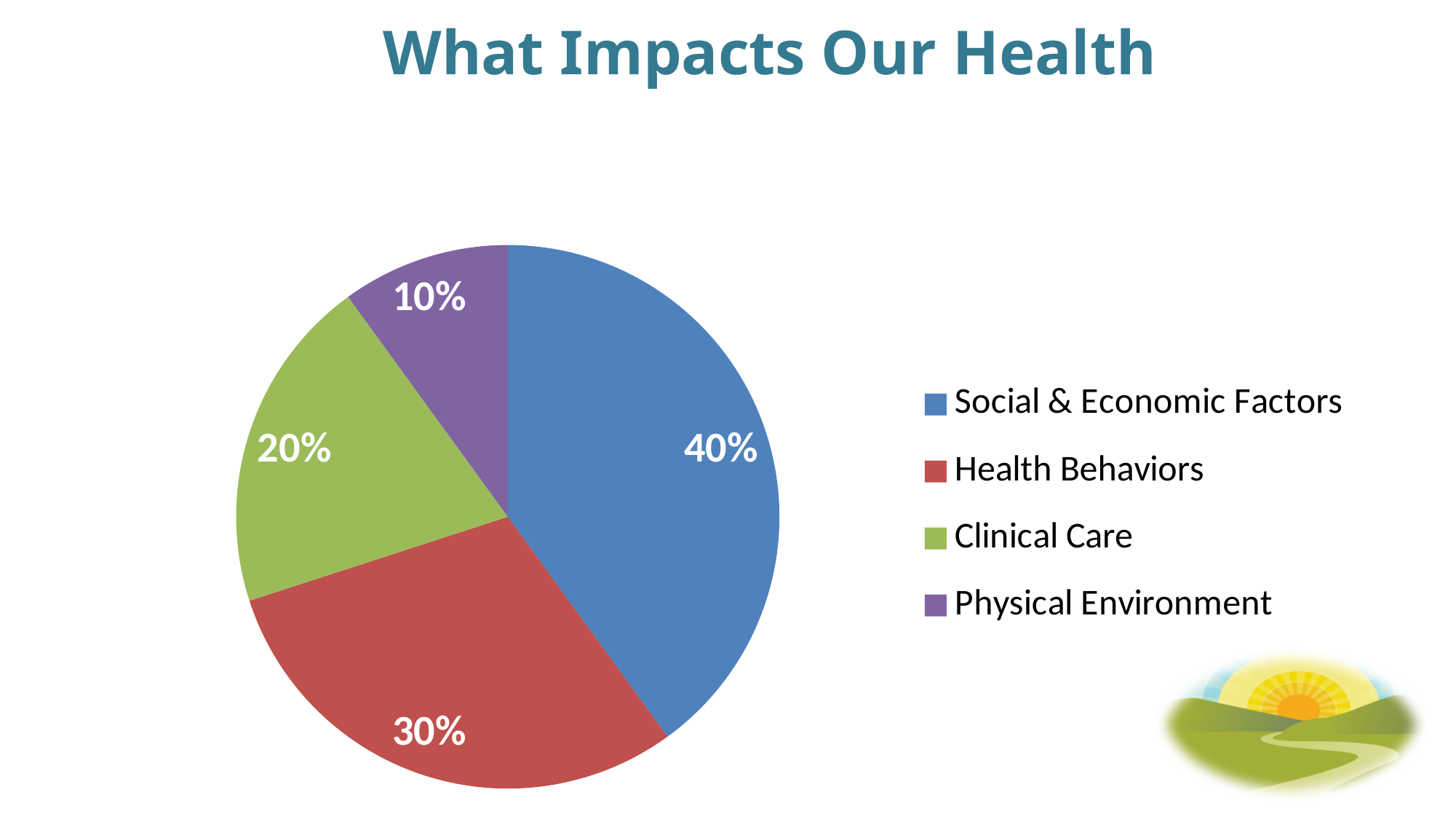
What colour is the Clinical Care slice? green What is the difference in percentage points between Social & Economic Factors and Clinical Care? 20 Which category has the smallest share of the pie? Physical Environment Which category has the largest share of the pie? Social & Economic Factors What percentage of the pie is Health Behaviors? 30% What kind of chart is shown on the slide? pie chart What percentage of the pie is Physical Environment? 10% What percentage of the pie is Social & Economic Factors? 40% How many categories does the pie chart have? 4 What percentage of the pie is Clinical Care? 20% Which is larger, Health Behaviors or Clinical Care? Health Behaviors What is the title of the chart? What Impacts Our Health